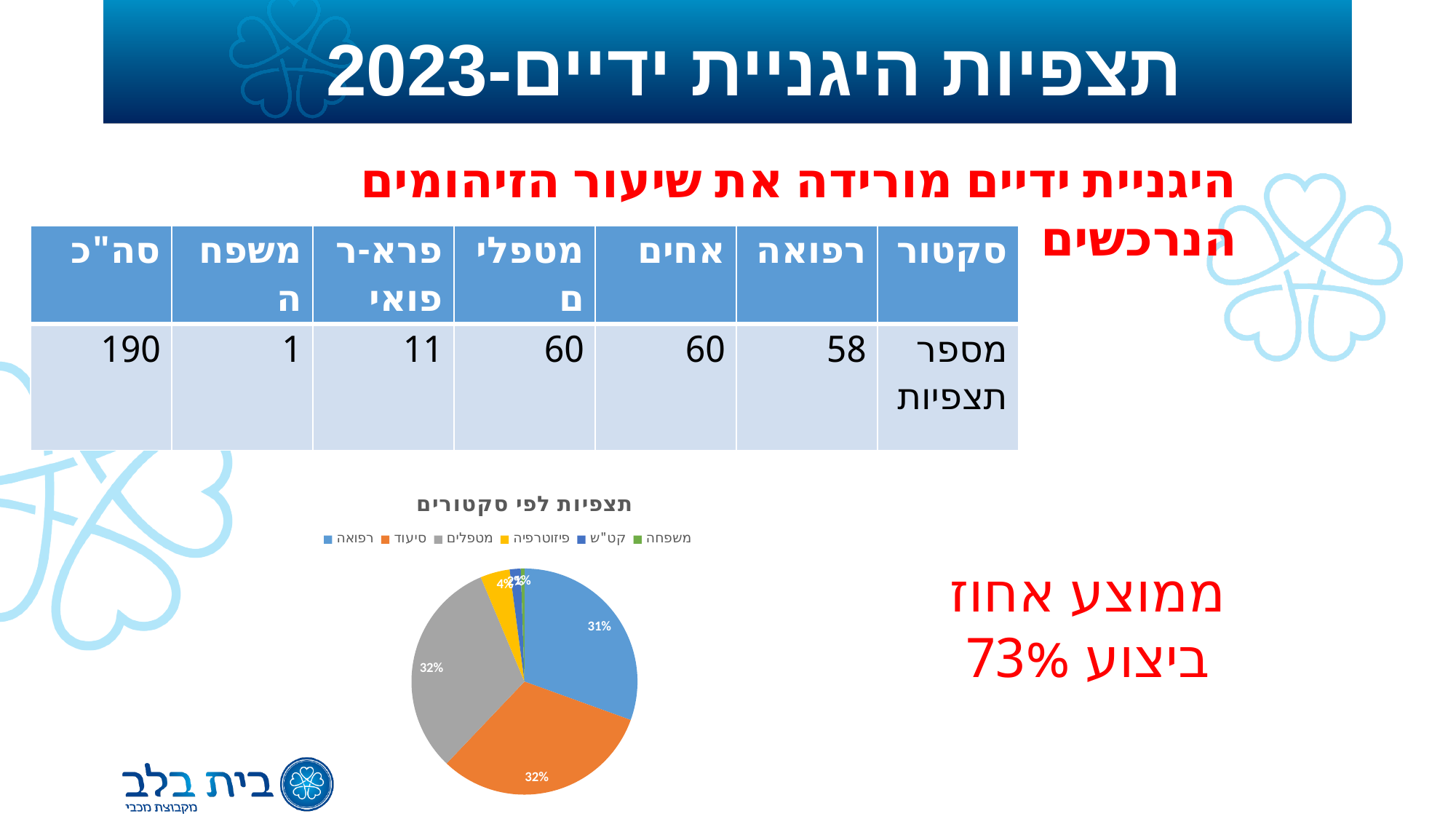
What kind of chart is shown on the slide? pie chart Which slice is larger in the pie chart, מטפלים or פיזיוטרפיה? מטפלים What share of the pie chart does פיזיוטרפיה have? 4% Which slice is larger in the pie chart, רפואה or פיזיוטרפיה? רפואה What colour is the רפואה slice in the pie chart? blue How many categories does the legend of the pie chart list? 6 By how many percentage points does the סיעוד slice exceed the רפואה slice? 1 How many slices does the pie chart have? 6 What is the title of the pie chart? תצפיות לפי סקטורים What share of the pie chart does סיעוד have? 32% What share of the pie chart does רפואה have? 31%